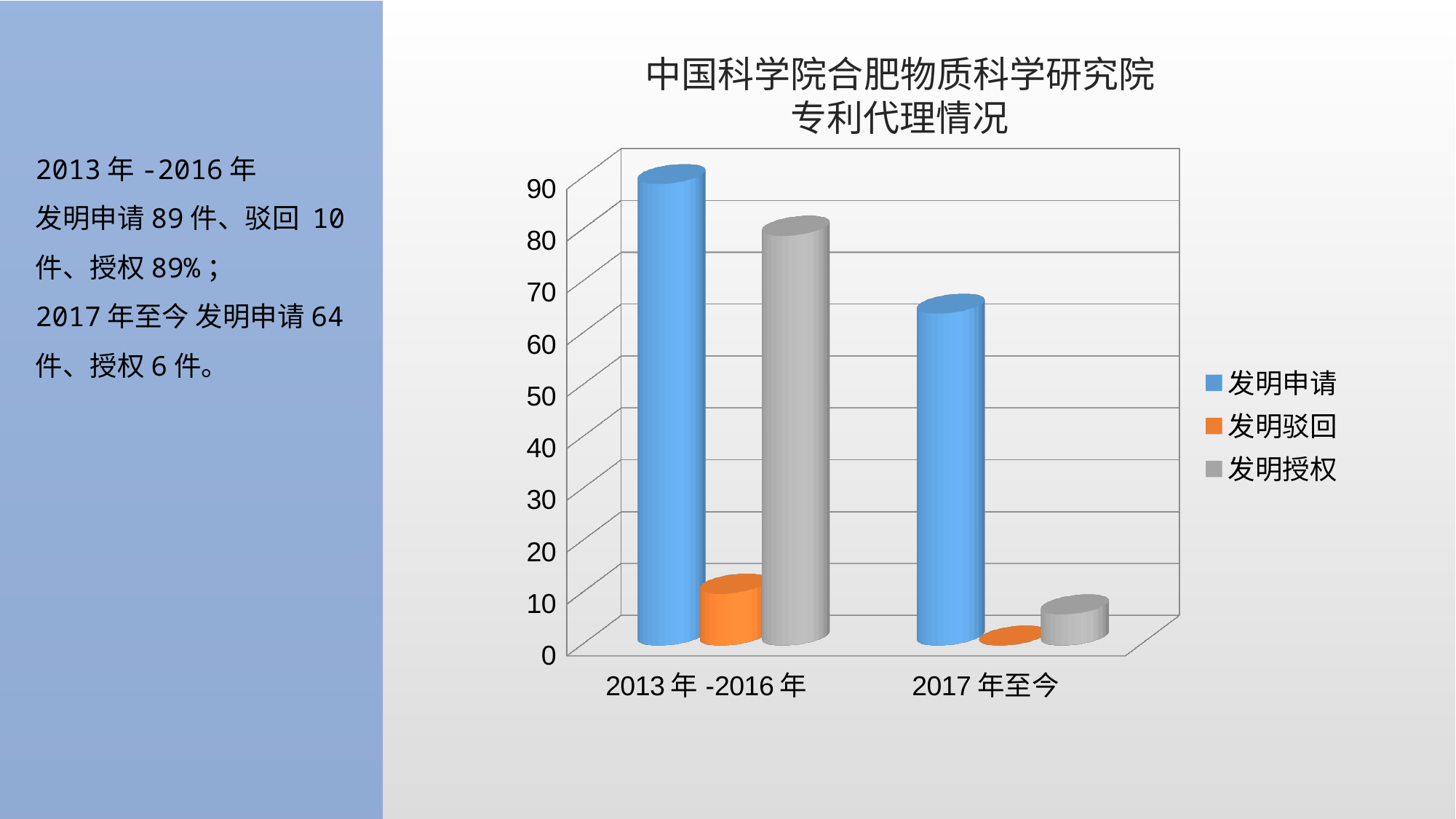
Which bar is the tallest in the chart? 发明申请 for 2013年-2016年 How many categories are shown on the x axis? 2 Which period has the larger value for 发明申请, 2013年-2016年 or 2017年至今? 2013年-2016年 Which bar is the shortest in the chart? 发明驳回 for 2017年至今 Does the value for 发明授权 rise or fall from 2013年-2016年 to 2017年至今? fall Is the value for 发明授权 in 2017年至今 greater or less than 10? less What kind of chart is shown on the slide? bar chart How many series does the legend list? 3 What colour represents 发明驳回 in the legend? orange Is the value for 发明授权 in 2013年-2016年 greater or less than 70? greater Is the value for 发明申请 in 2013年-2016年 greater or less than 80? greater